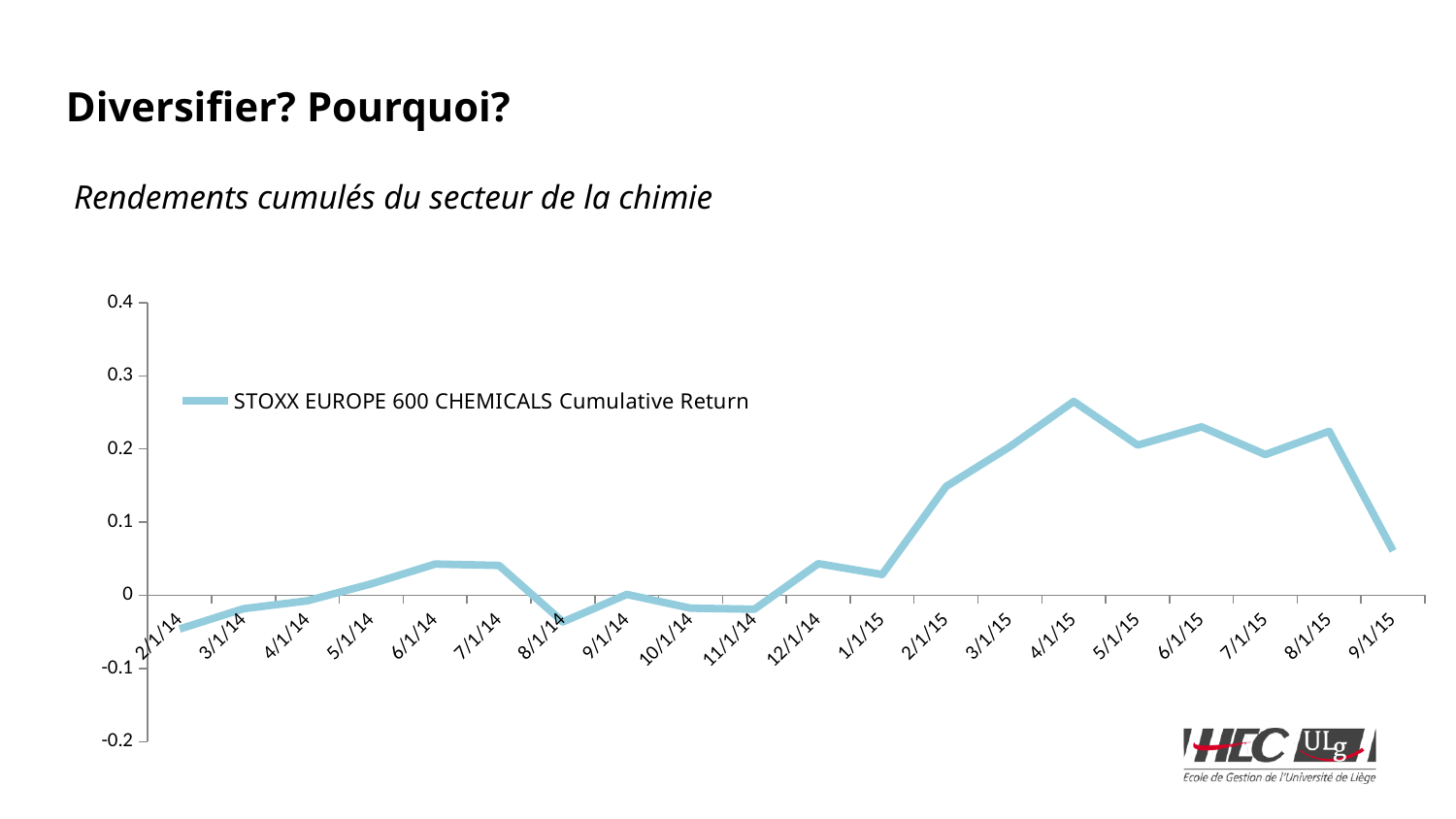
How many dates are labelled along the x axis? 20 Is the value for 9/1/15 greater or less than 0.1? less Does the cumulative return rise or fall between 11/1/14 and 4/1/15? Rise Which date has the larger cumulative return, 8/1/15 or 9/1/15? 8/1/15 Does the cumulative return rise or fall between 8/1/15 and 9/1/15? Fall What is the name of the series shown in the legend? STOXX EUROPE 600 CHEMICALS Cumulative Return Is the value for 4/1/15 greater or less than 0.2? greater Is the value for 2/1/15 greater or less than 0.1? greater On which date does the cumulative return reach its highest point? 4/1/15 What kind of chart is shown on the slide? Line chart How many series does the legend list? 1